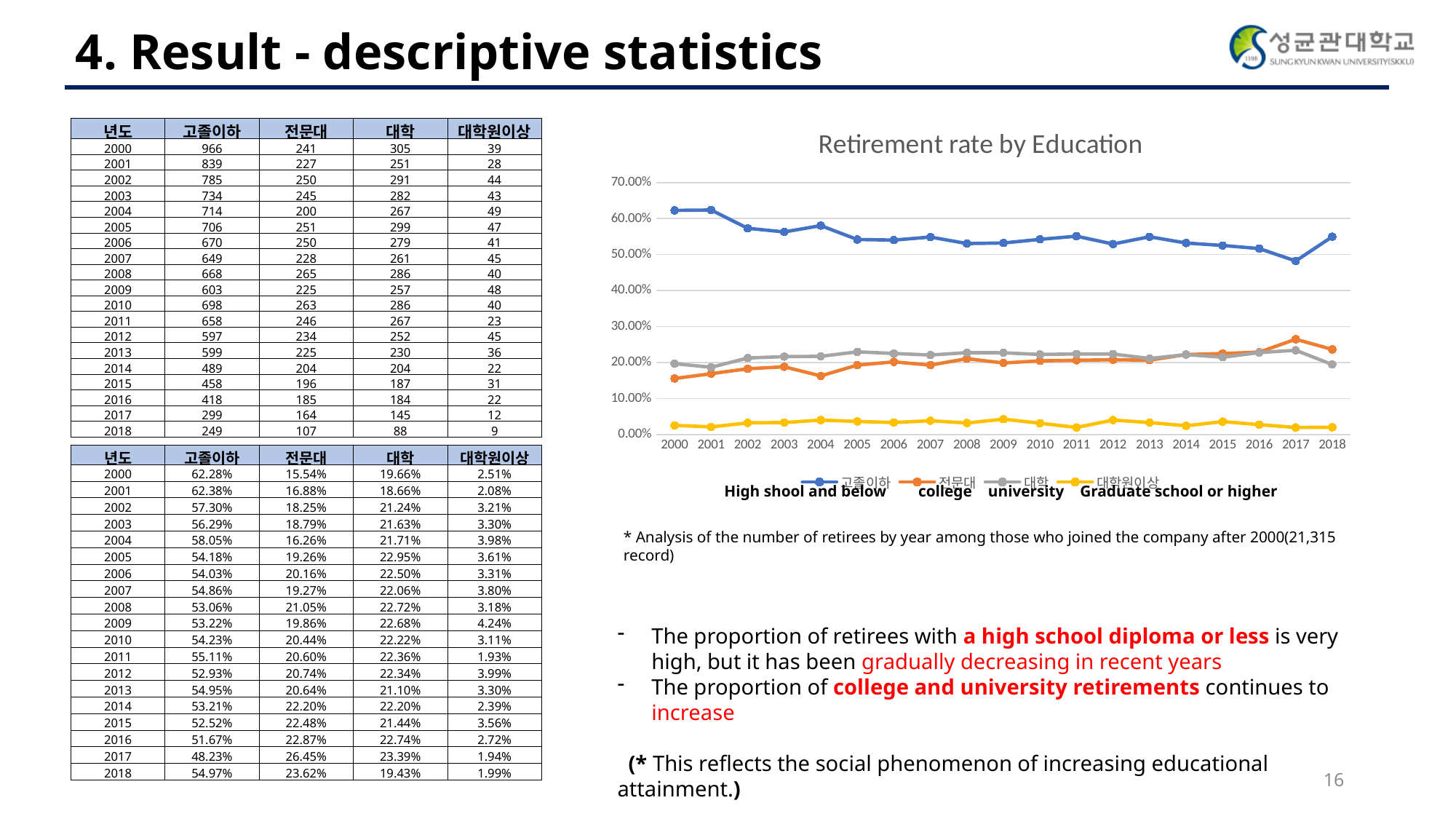
Is the value for High school and below in 2000 greater or less than 60.00%? greater How many series does the chart's legend list? 4 Which education group has the lowest retirement rate across all years in the chart? Graduate school or higher Does the High school and below line generally rise or fall from 2000 to 2017? fall Is the value for High school and below in 2017 greater or less than 50.00%? less In which year does the college line reach its highest value? 2017 In which year is the retirement rate for High school and below at its lowest? 2017 What kind of chart is shown on the slide? Line chart What is the title of the chart? Retirement rate by Education How many years are plotted along the x axis of the chart? 19 Which education group has the highest retirement rate across all years in the chart? High school and below In 2018, which is larger: the retirement rate for college or for university? college